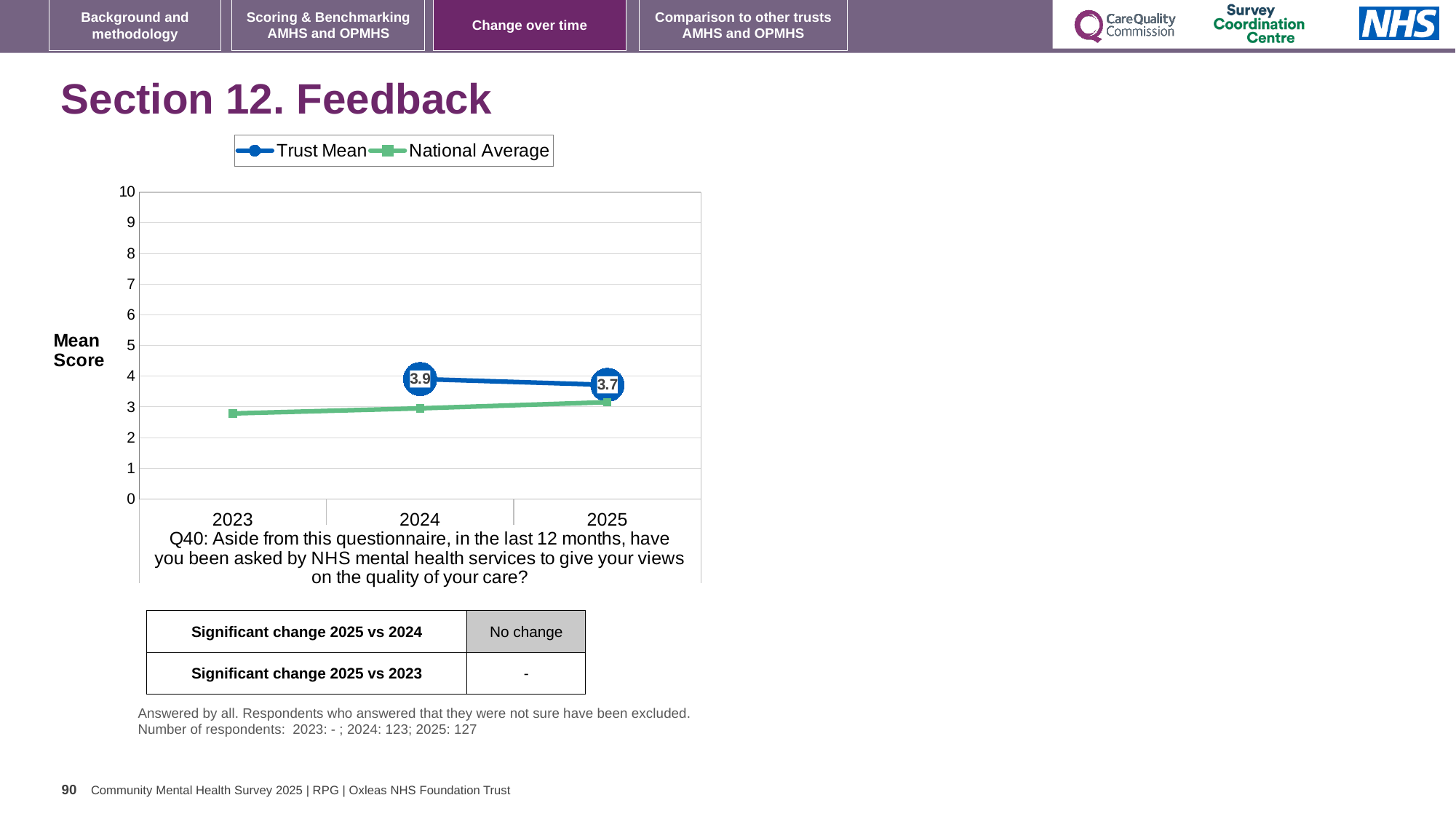
What is the Trust Mean value for 2024? 3.9 What is the difference between the Trust Mean in 2024 and in 2025? 0.2 How many years are shown on the x axis? 3 Does the National Average rise or fall from 2023 to 2025? rise In 2025, which is larger, the Trust Mean or the National Average? Trust Mean Is the National Average value for 2023 greater or less than 3? less Is the National Average value for 2025 greater or less than 4? less How many series does the legend list? 2 What kind of chart is shown on the slide? line chart Which year has the higher Trust Mean, 2024 or 2025? 2024 What is the Trust Mean value for 2025? 3.7 Does the Trust Mean rise or fall from 2024 to 2025? fall